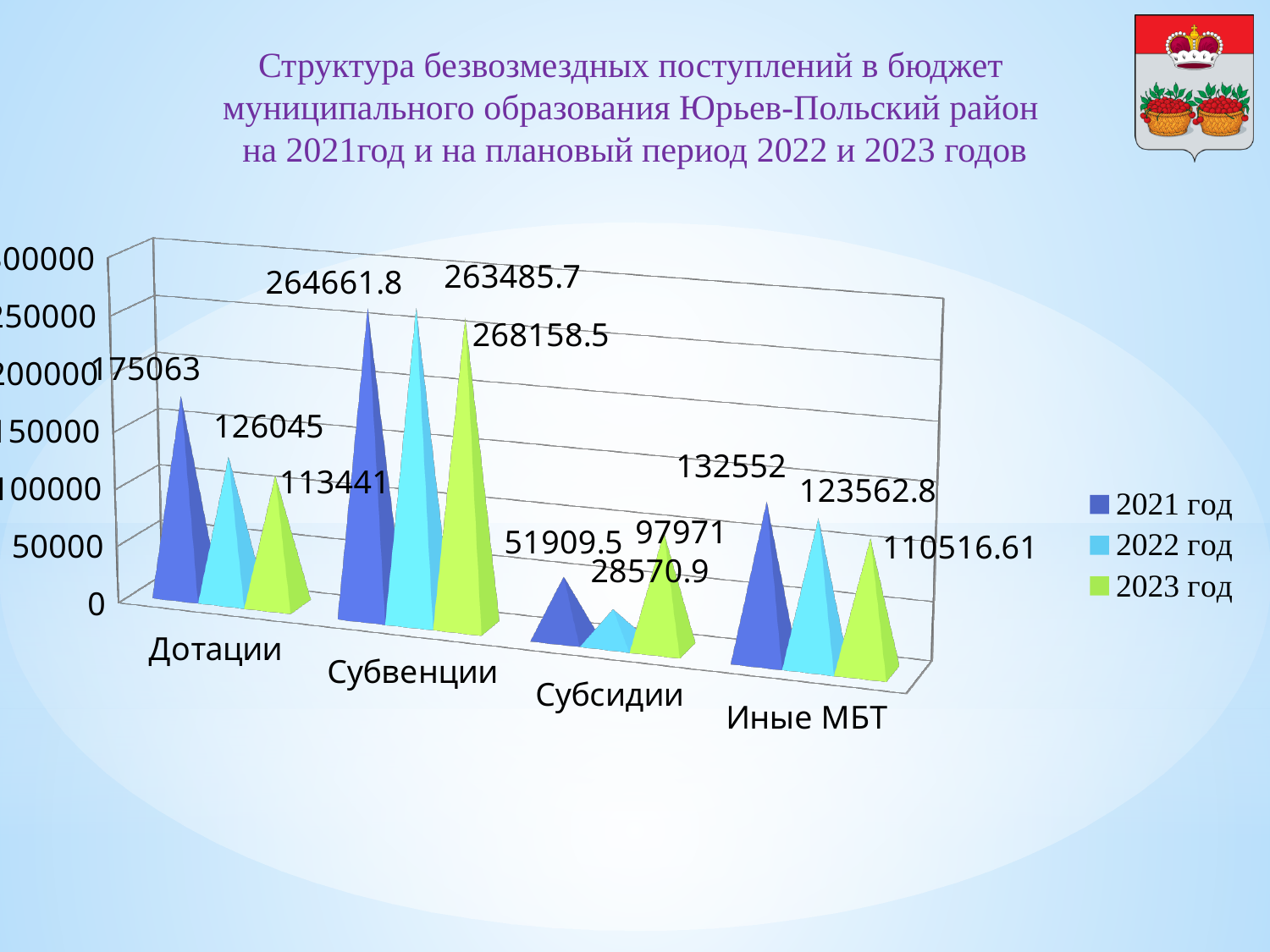
What is the value for Субвенции in the 2023 год series? 263485.7 How many categories are shown on the x axis? 4 What is the value for Субсидии in the 2022 год series? 28570.9 Do the values for Иные МБТ rise or fall from 2021 год to 2023 год? Fall What is the value for Иные МБТ in the 2023 год series? 110516.61 Which category has the lowest value in the 2022 год series? Субсидии How many series does the legend list? 3 What is the difference between the 2021 год and 2022 год values for Дотации? 49018 What is the value for Дотации in the 2021 год series? 175063 Which is larger for Субсидии: the 2021 год value or the 2023 год value? 2023 год What kind of chart is shown on the slide? Bar chart Which category has the highest value in the 2021 год series? Субвенции